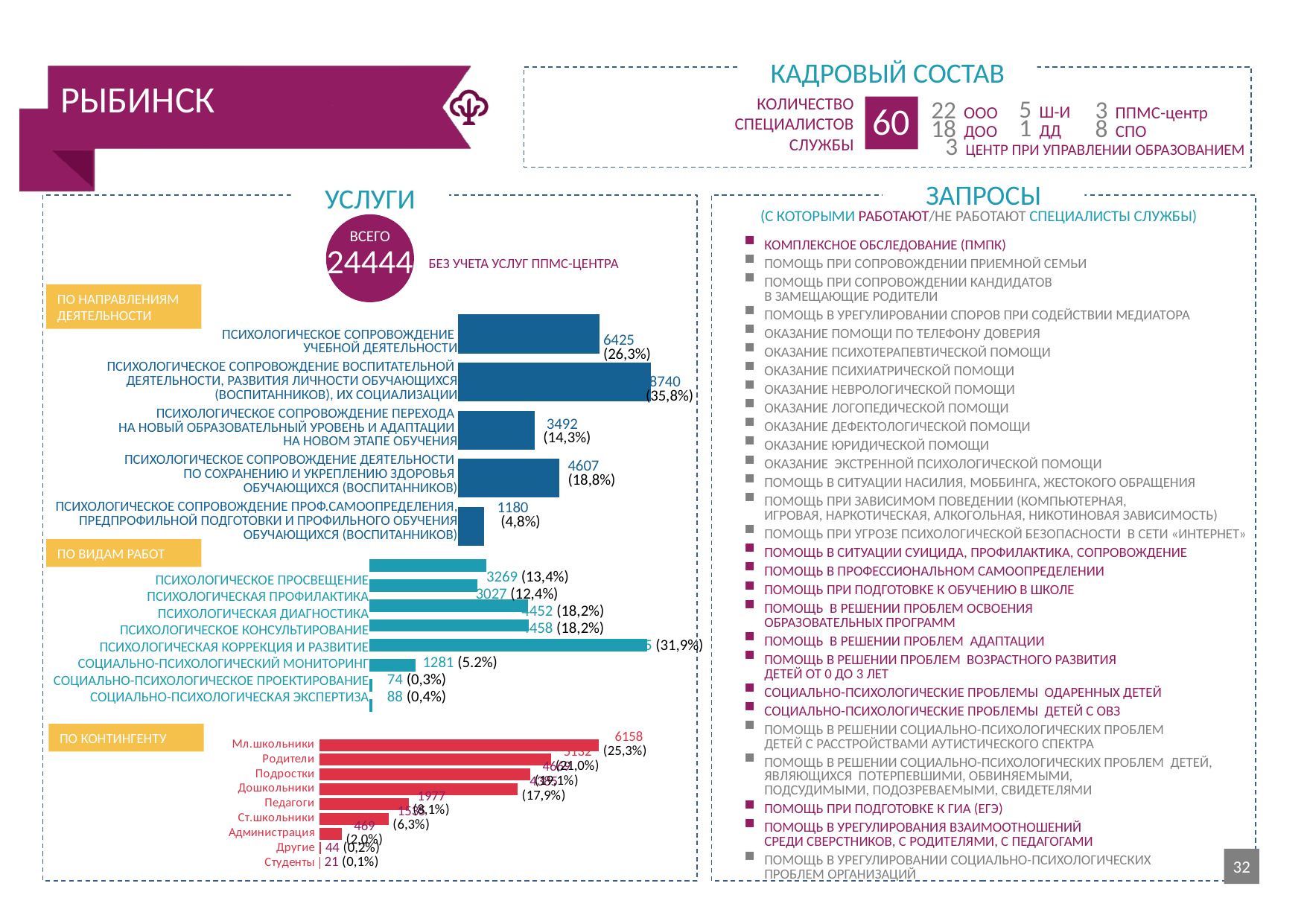
In the 'ПО ВИДАМ РАБОТ' chart, which category has the lowest value? Социально-психологическое проектирование In the 'ПО НАПРАВЛЕНИЯМ ДЕЯТЕЛЬНОСТИ' chart, which category has the highest value? Психологическое сопровождение воспитательной деятельности, развития личности обучающихся (воспитанников), их социализации How many categories does the 'ПО НАПРАВЛЕНИЯМ ДЕЯТЕЛЬНОСТИ' chart show? 5 In the 'ПО ВИДАМ РАБОТ' chart, which is larger: 'Психологическое просвещение' or 'Психологическая профилактика'? Психологическое просвещение In the 'ПО ВИДАМ РАБОТ' chart, which category has the longest bar? Психологическая коррекция и развитие In the 'ПО КОНТИНГЕНТУ' chart, what is the value for 'Мл.школьники'? 6158 In the 'ПО НАПРАВЛЕНИЯМ ДЕЯТЕЛЬНОСТИ' chart, which category has the lowest value? Психологическое сопровождение проф.самоопределения, предпрофильной подготовки и профильного обучения обучающихся (воспитанников) In the 'ПО НАПРАВЛЕНИЯМ ДЕЯТЕЛЬНОСТИ' chart, what is the value for 'Психологическое сопровождение учебной деятельности'? 6425 In the 'ПО ВИДАМ РАБОТ' chart, what is the value for 'Психологическое просвещение'? 3269 In the 'ПО НАПРАВЛЕНИЯМ ДЕЯТЕЛЬНОСТИ' chart, what is the difference between the values for 'Психологическое сопровождение деятельности по сохранению и укреплению здоровья' and 'Психологическое сопровождение перехода на новый образовательный уровень'? 1115 What percentage share is shown for 'Психологическое сопровождение перехода на новый образовательный уровень' in the 'ПО НАПРАВЛЕНИЯМ ДЕЯТЕЛЬНОСТИ' chart? 14,3% What type of chart is used in the 'ПО КОНТИНГЕНТУ' section? Bar chart